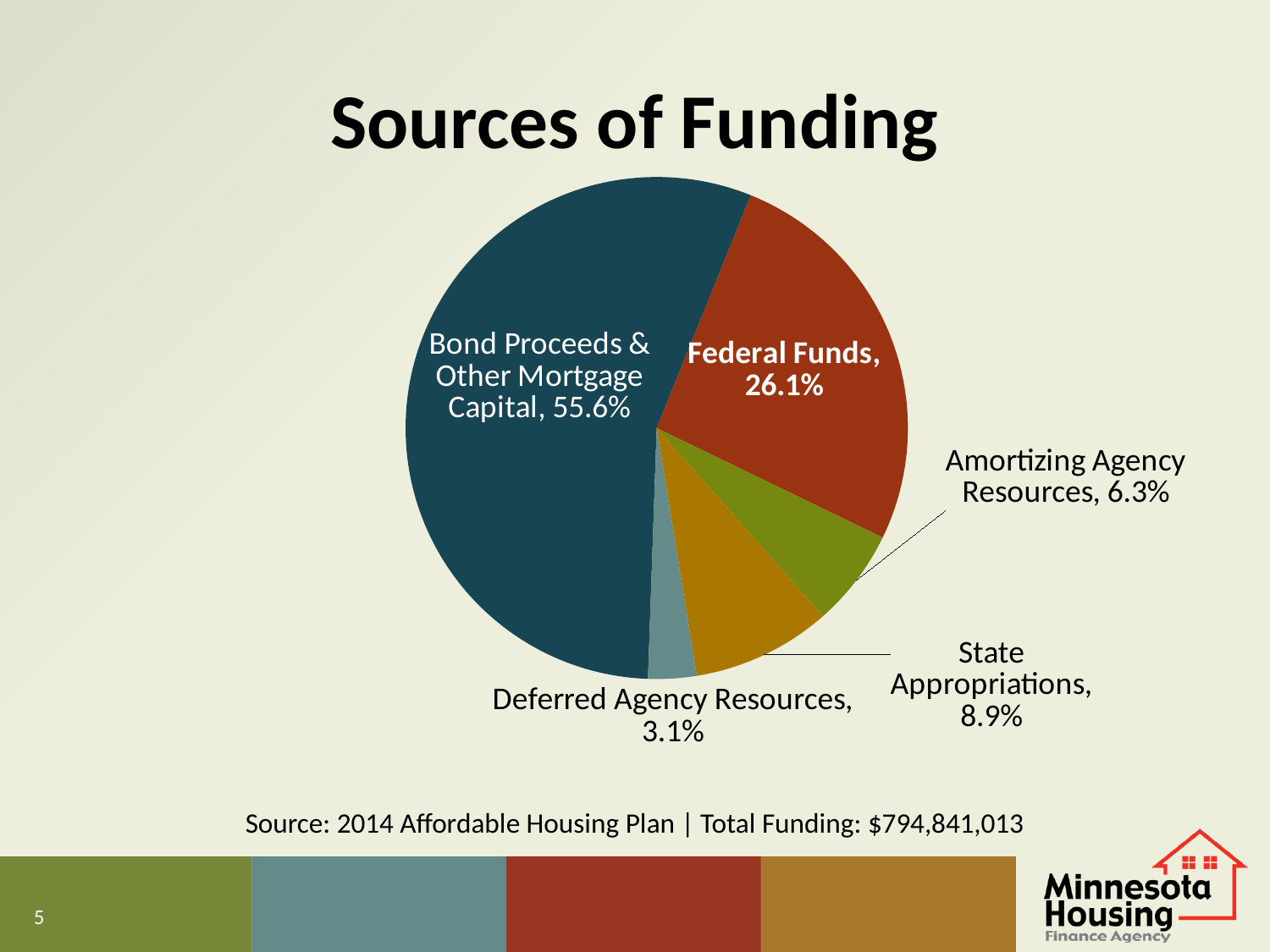
What share of funding comes from Bond Proceeds & Other Mortgage Capital? 55.6% What share of funding comes from Federal Funds? 26.1% Which funding source has the smallest share? Deferred Agency Resources What is the title of the chart? Sources of Funding How many funding sources are shown in the pie chart? 5 What share of funding comes from State Appropriations? 8.9% Which funding source has the largest share? Bond Proceeds & Other Mortgage Capital What share of funding comes from Deferred Agency Resources? 3.1% What is the difference in share between Federal Funds and State Appropriations? 17.2% Which is larger, the share for Amortizing Agency Resources or the share for State Appropriations? State Appropriations What kind of chart is shown on the slide? pie chart What share of funding comes from Amortizing Agency Resources? 6.3%